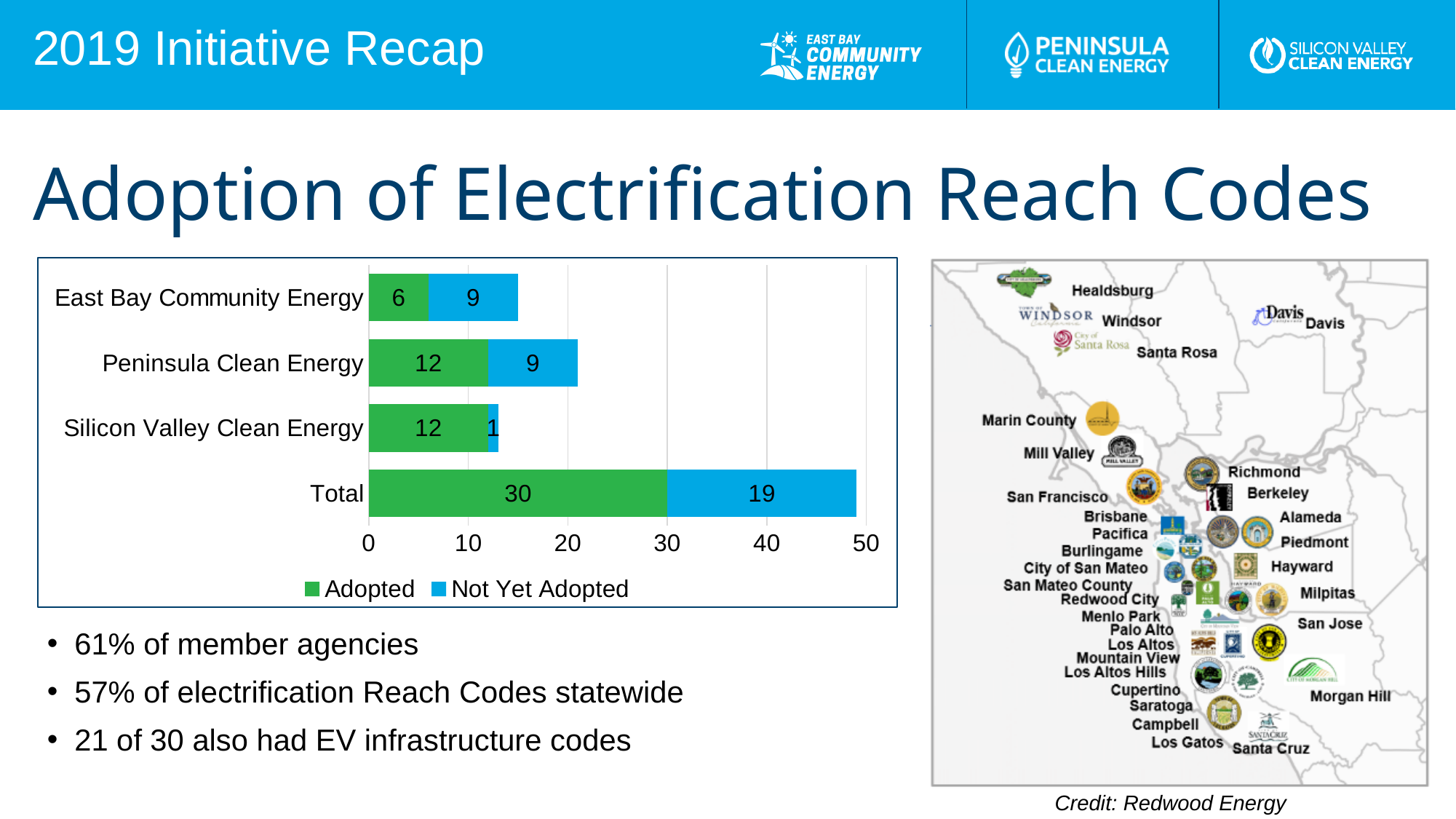
Which is larger for Peninsula Clean Energy, the Adopted value or the Not Yet Adopted value? Adopted What is the total of the stacked bar for East Bay Community Energy? 15 What is the difference between the Adopted and Not Yet Adopted values for the Total bar? 11 What kind of chart is shown on the slide? Stacked bar chart What is the Adopted value for East Bay Community Energy? 6 What is the Not Yet Adopted value for the Total bar? 19 What is the Adopted value for Peninsula Clean Energy? 12 What is the total of the stacked bar for Peninsula Clean Energy? 21 Excluding the Total bar, which agency has the lowest Not Yet Adopted value? Silicon Valley Clean Energy How many series does the legend list? 2 Excluding the Total bar, which agency has the lowest Adopted value? East Bay Community Energy What is the Not Yet Adopted value for Silicon Valley Clean Energy? 1